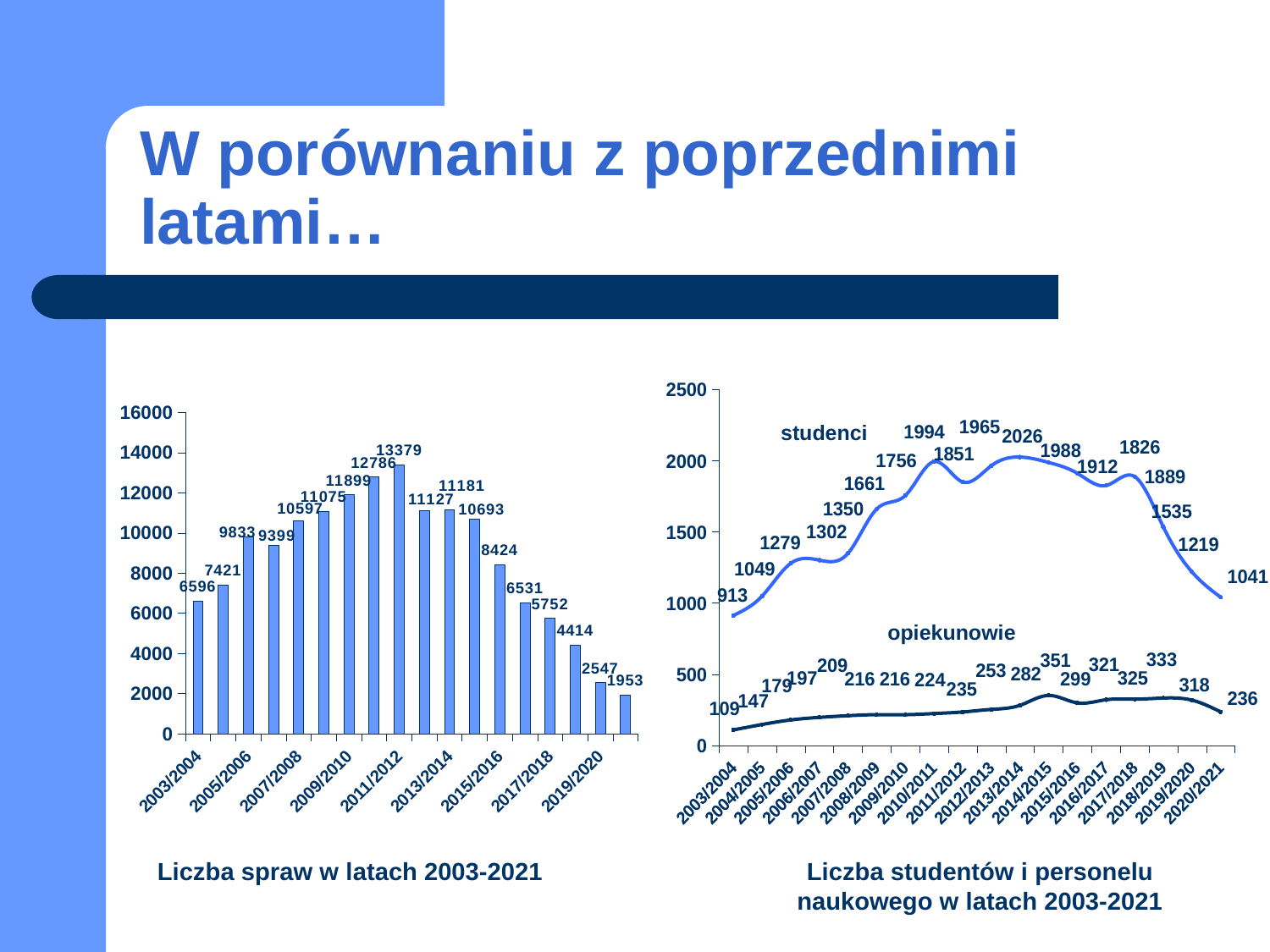
What kind of chart is the right chart, 'Liczba studentów i personelu naukowego w latach 2003-2021'? line chart In the left chart 'Liczba spraw w latach 2003-2021', what is the lowest value shown? 1953 In the left chart 'Liczba spraw w latach 2003-2021', what is the value for 2019/2020? 2547 In the left chart 'Liczba spraw w latach 2003-2021', what is the difference between the value for 2011/2012 and the value for 2003/2004? 6783 In the left chart 'Liczba spraw w latach 2003-2021', what is the value for 2003/2004? 6596 In the right chart, what is the value of the 'studenci' series for 2003/2004? 913 How many bars are plotted in the left chart 'Liczba spraw w latach 2003-2021'? 18 What kind of chart is the left chart, 'Liczba spraw w latach 2003-2021'? bar chart In the left chart 'Liczba spraw w latach 2003-2021', what is the highest value shown? 13379 In the right chart, what is the highest value of the 'opiekunowie' series? 351 In the right chart, what is the highest value of the 'studenci' series? 2026 How many series are plotted in the right chart 'Liczba studentów i personelu naukowego w latach 2003-2021'? 2